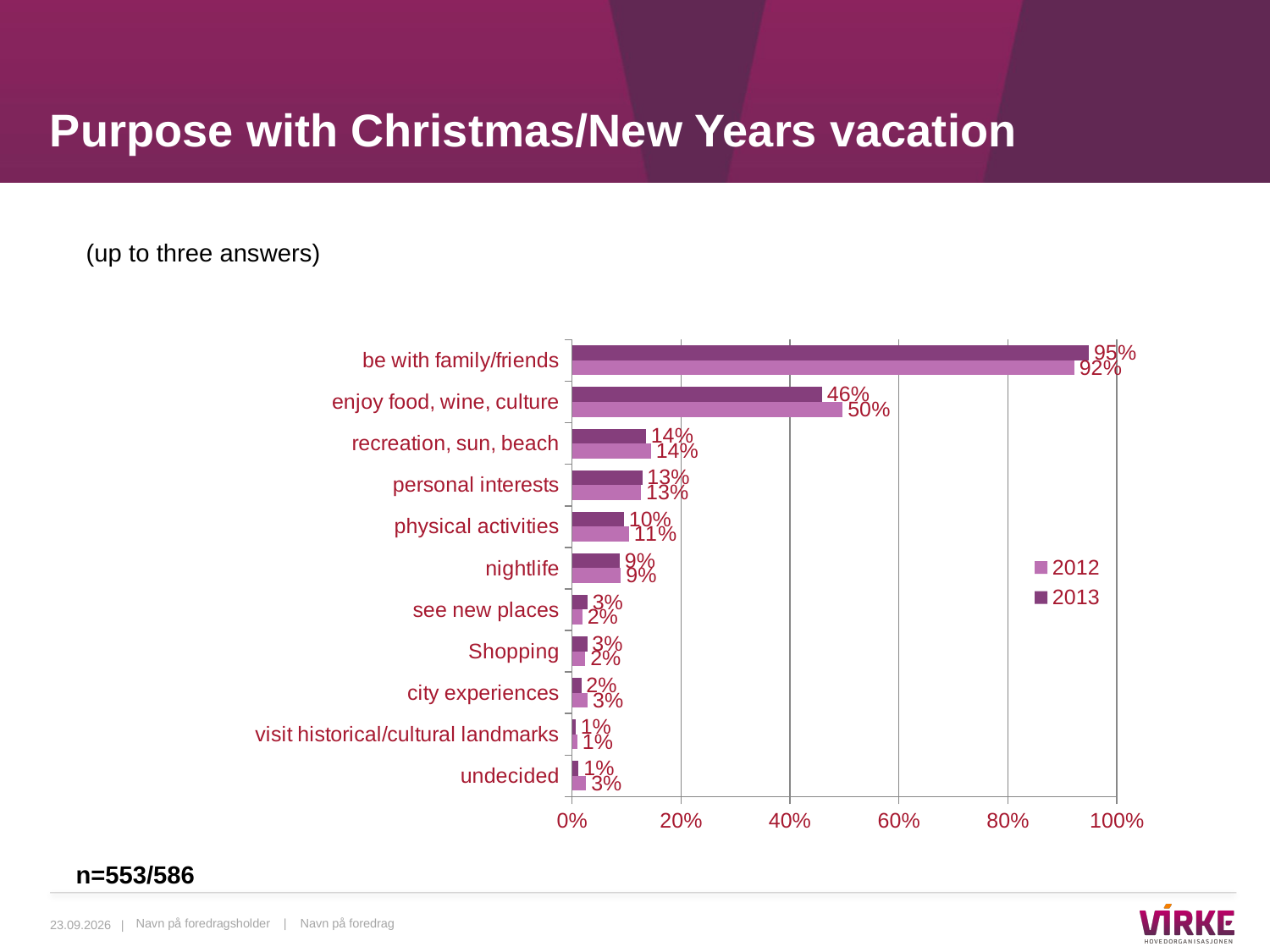
What is the 2013 value for 'be with family/friends'? 95% What is the difference between the 2012 and 2013 values for 'enjoy food, wine, culture'? 4% Which category has the highest value in 2013? be with family/friends What is the 2013 value for 'city experiences'? 2% Which is larger for 'undecided': the 2012 value or the 2013 value? 2012 Is the 2013 value for 'enjoy food, wine, culture' greater or less than 60%? less How many series does the legend list? 2 What kind of chart is shown on the slide? bar chart How many categories are shown on the chart? 11 What is the 2012 value for 'enjoy food, wine, culture'? 50% What is the 2012 value for 'physical activities'? 11% What is the difference between the 2013 and 2012 values for 'be with family/friends'? 3%